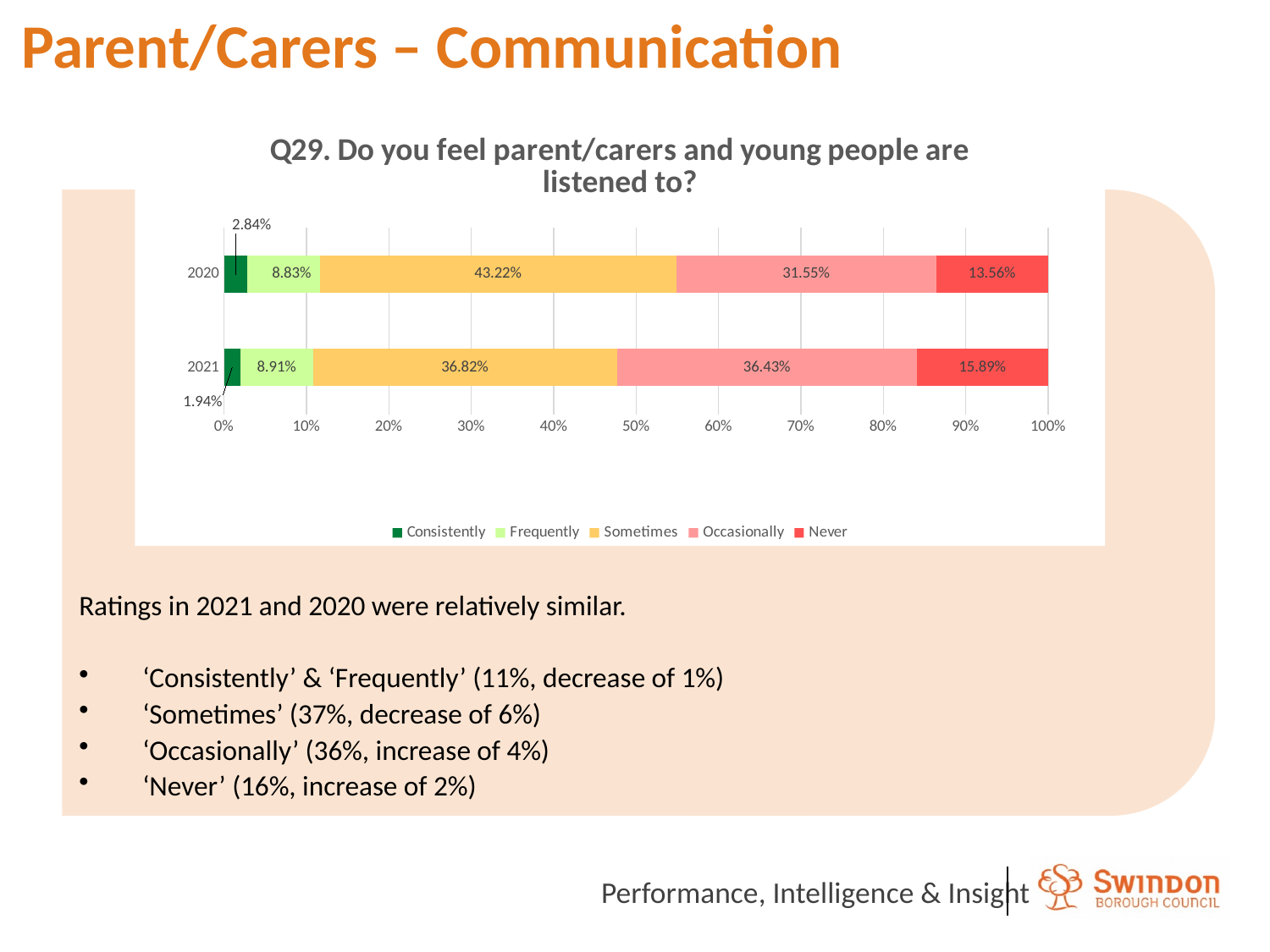
Which response category has the smallest share in 2021? Consistently What is the difference between the 'Sometimes' values for 2020 and 2021? 6.40% What kind of chart is shown? Stacked bar chart What is the title of the chart? Q29. Do you feel parent/carers and young people are listened to? Which response category has the largest share in 2020? Sometimes What is the value for 'Sometimes' in 2020? 43.22% Which year has the larger value for 'Occasionally'? 2021 How many years are shown on the chart? 2 What is the value for 'Never' in 2021? 15.89% How many series does the legend list? 5 What is the value for 'Occasionally' in 2020? 31.55% What is the value for 'Consistently' in 2021? 1.94%